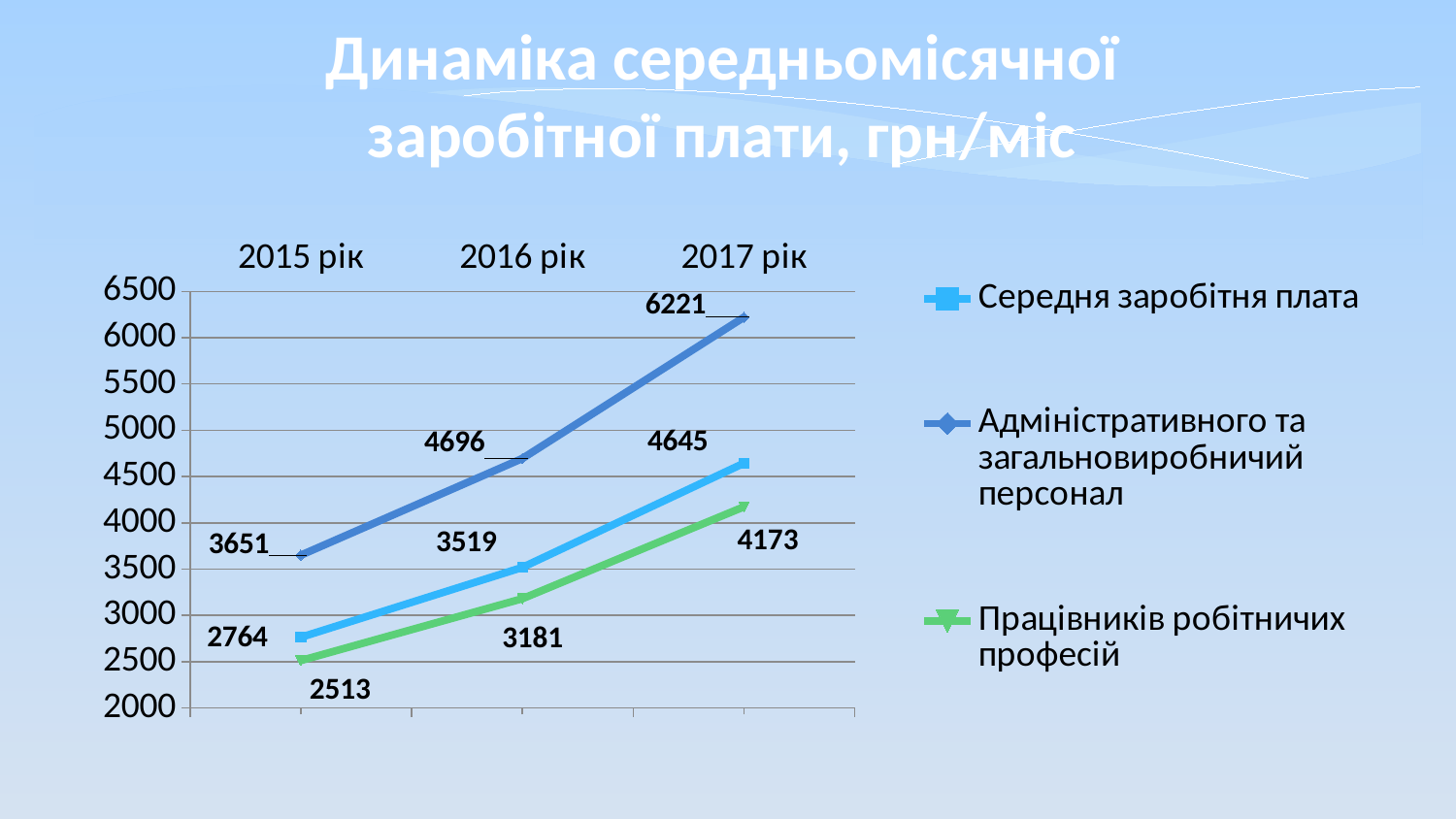
What value is shown for Адміністративного та загальновиробничий персонал in 2017 рік? 6221 In which year is the value for Працівників робітничих професій lowest? 2015 рік What value is shown for Працівників робітничих професій in 2016 рік? 3181 Which is larger in 2016 рік: Середня заробітня плата or Працівників робітничих професій? Середня заробітня плата How many series does the legend list? 3 By how much did Середня заробітня плата increase from 2015 рік to 2017 рік? 1881 What kind of chart is shown on the slide? Line chart Do the values for Середня заробітня плата rise or fall from 2015 рік to 2017 рік? Rise In which year is the value for Адміністративного та загальновиробничий персонал highest? 2017 рік Is the value for Адміністративного та загальновиробничий персонал in 2016 рік greater or less than 4500? greater What is the difference between Адміністративного та загальновиробничий персонал and Працівників робітничих професій in 2017 рік? 2048 What was the average salary (Середня заробітня плата) in 2015 рік? 2764